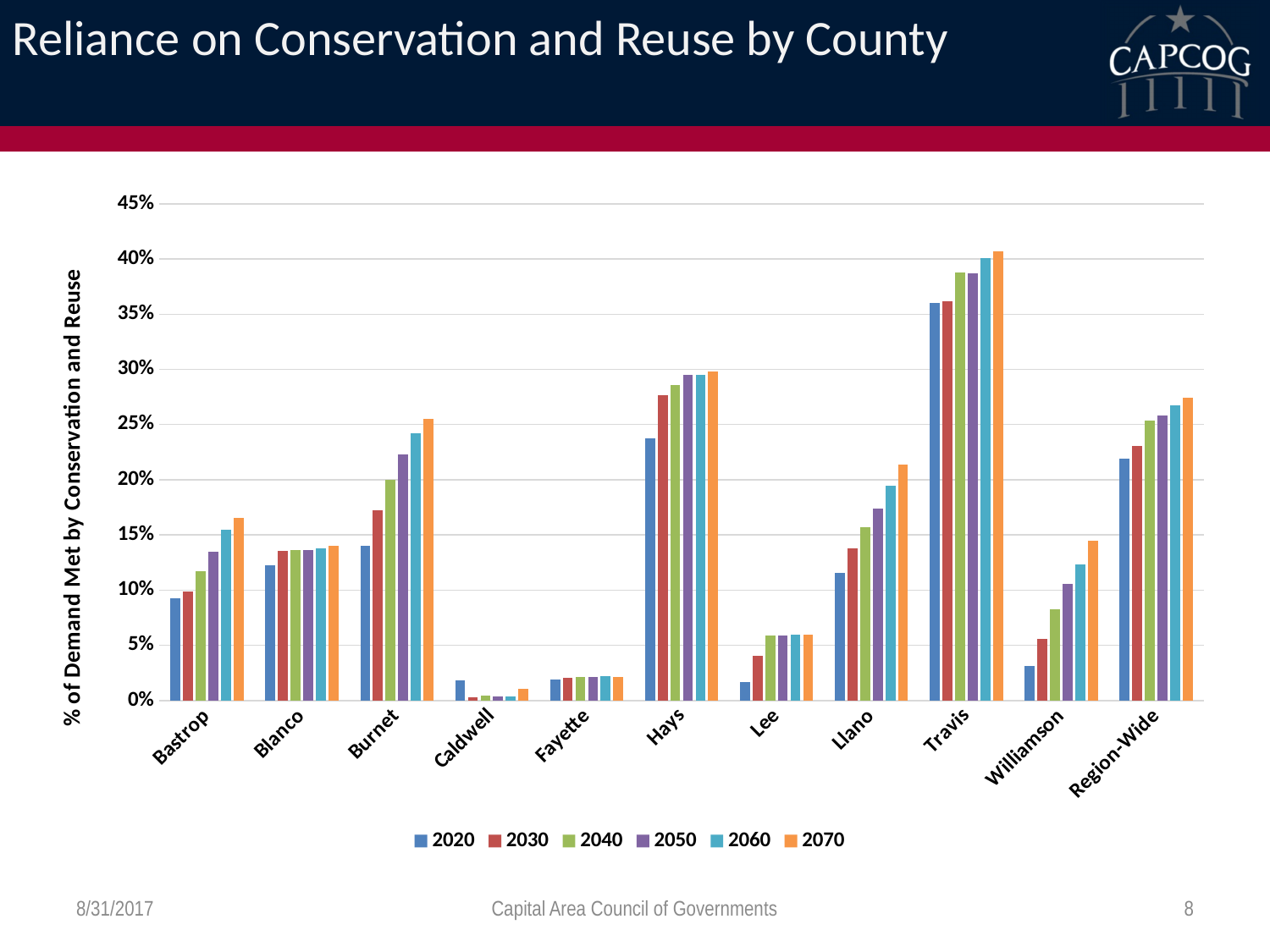
Is the 2020 value for Hays greater or less than 20%? greater Which category has the lowest values for conservation and reuse? Caldwell How many counties/categories are shown along the x axis? 11 Is the 2020 value for Williamson greater or less than 5%? less Which is larger, the 2070 value for Burnet or the 2070 value for Blanco? Burnet What kind of chart is shown on the slide? bar chart Which category has the highest values for conservation and reuse? Travis Is the 2040 value for Lee greater or less than 10%? less Do the values for Bastrop rise or fall from 2020 to 2070? rise What is the label on the vertical axis? % of Demand Met by Conservation and Reuse How many series does the legend list? 6